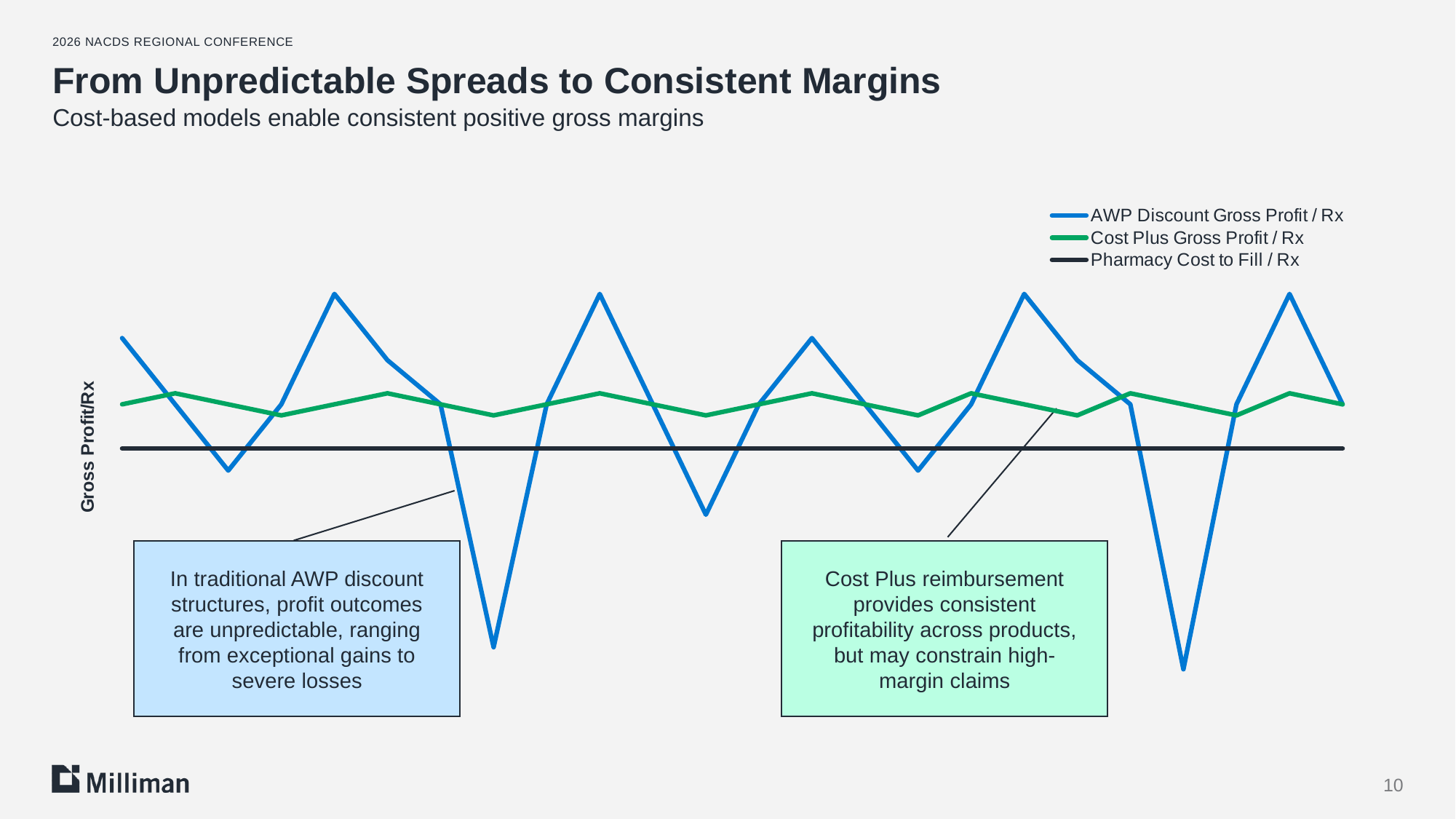
Does the AWP Discount Gross Profit / Rx line ever fall below the Pharmacy Cost to Fill / Rx line? Yes What is the label on the chart's vertical axis? Gross Profit/Rx How many series does the chart's legend list? 3 Which series is drawn as the blue line? AWP Discount Gross Profit / Rx Which series shows the greatest swings up and down across the chart? AWP Discount Gross Profit / Rx At the lowest point of the AWP Discount Gross Profit / Rx line, which series is higher: AWP Discount Gross Profit / Rx or Cost Plus Gross Profit / Rx? Cost Plus Gross Profit / Rx Does the Pharmacy Cost to Fill / Rx line rise, fall, or stay flat across the chart? Stays flat What kind of chart is shown on the slide? Line chart